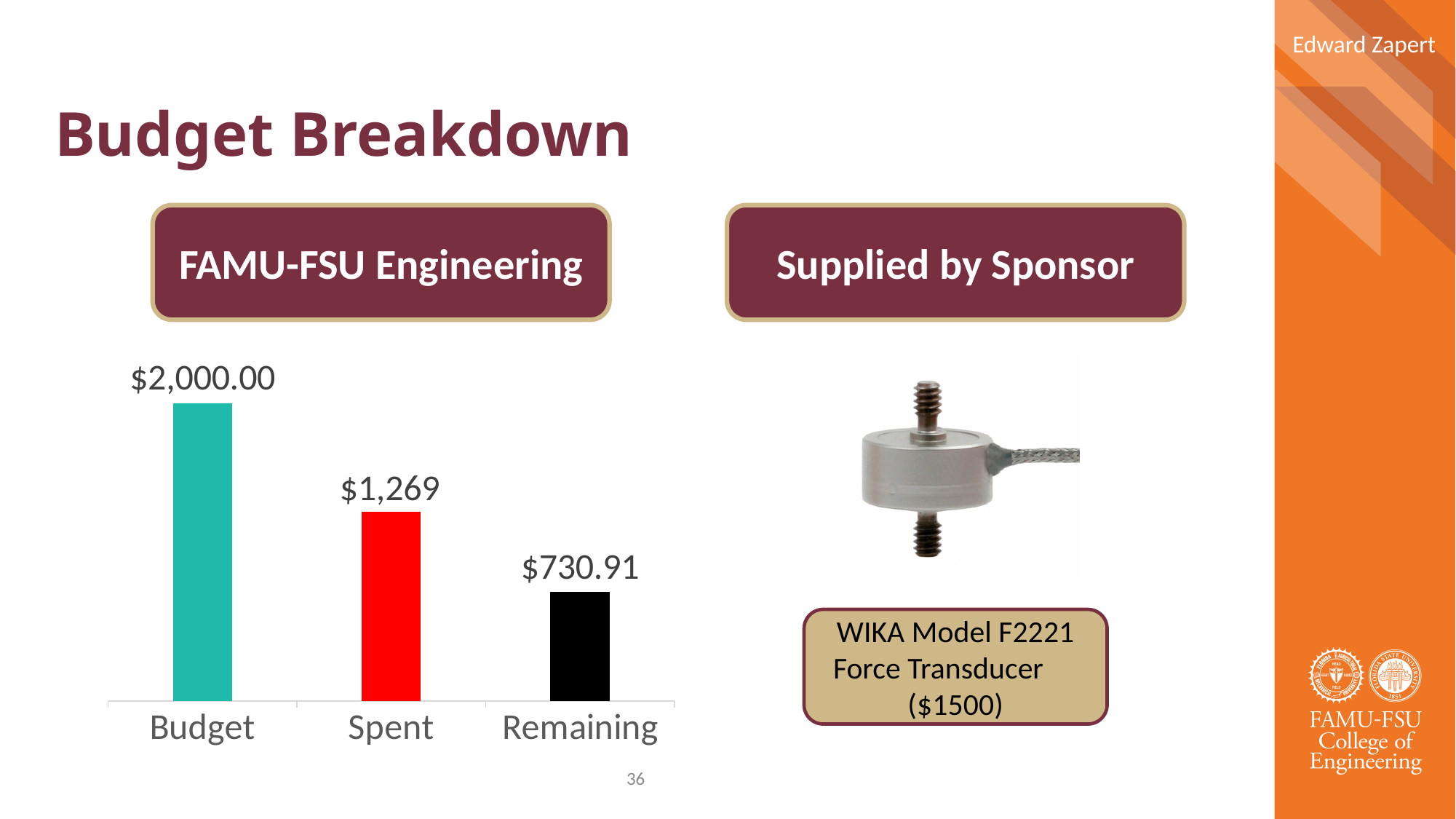
What is the value of the Remaining bar in the chart? $730.91 What is the difference between the Budget value and the Spent value? $731 What is the value of the Budget bar in the chart? $2,000.00 Which category has the lowest value in the chart? Remaining What is the heading above the bar chart? FAMU-FSU Engineering Which is larger, the Spent value or the Remaining value? Spent Do the bar values rise or fall from left to right across the chart? Fall What colour is the Spent bar in the chart? Red How many categories are shown in the bar chart? 3 Which category has the highest value in the chart? Budget What kind of chart is shown on the slide? Bar chart What is the value of the Spent bar in the chart? $1,269